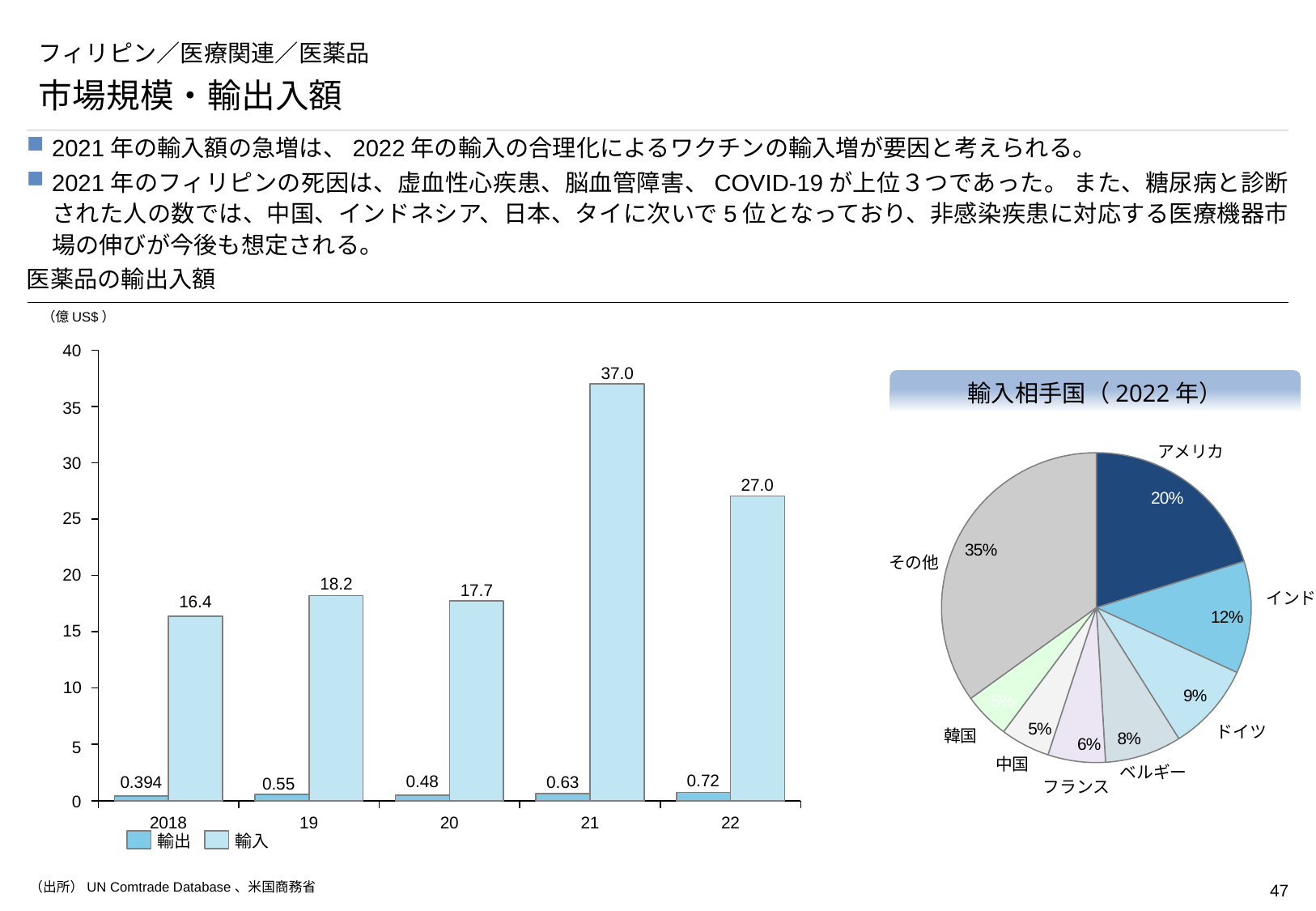
In the bar chart 医薬品の輸出入額, which is larger, the 輸入 value for 19 or for 20? 19 In the pie chart 輸入相手国（2022年）, which named country has the largest share? アメリカ In the bar chart 医薬品の輸出入額, which year has the highest 輸入 value? 21 In the bar chart 医薬品の輸出入額, how many years are shown on the x axis? 5 In the bar chart 医薬品の輸出入額, how many series does the legend list? 2 In the bar chart 医薬品の輸出入額, what is the value of 輸入 for 22? 27.0 What kind of chart is 輸入相手国（2022年）? pie chart In the bar chart 医薬品の輸出入額, what is the difference between the 輸入 values for 21 and 22? 10.0 In the bar chart 医薬品の輸出入額, which year has the lowest 輸出 value? 2018 In the bar chart 医薬品の輸出入額, what is the value of 輸入 for 21? 37.0 In the bar chart 医薬品の輸出入額, what is the value of 輸出 for 2018? 0.394 In the pie chart 輸入相手国（2022年）, what share does アメリカ have? 20%